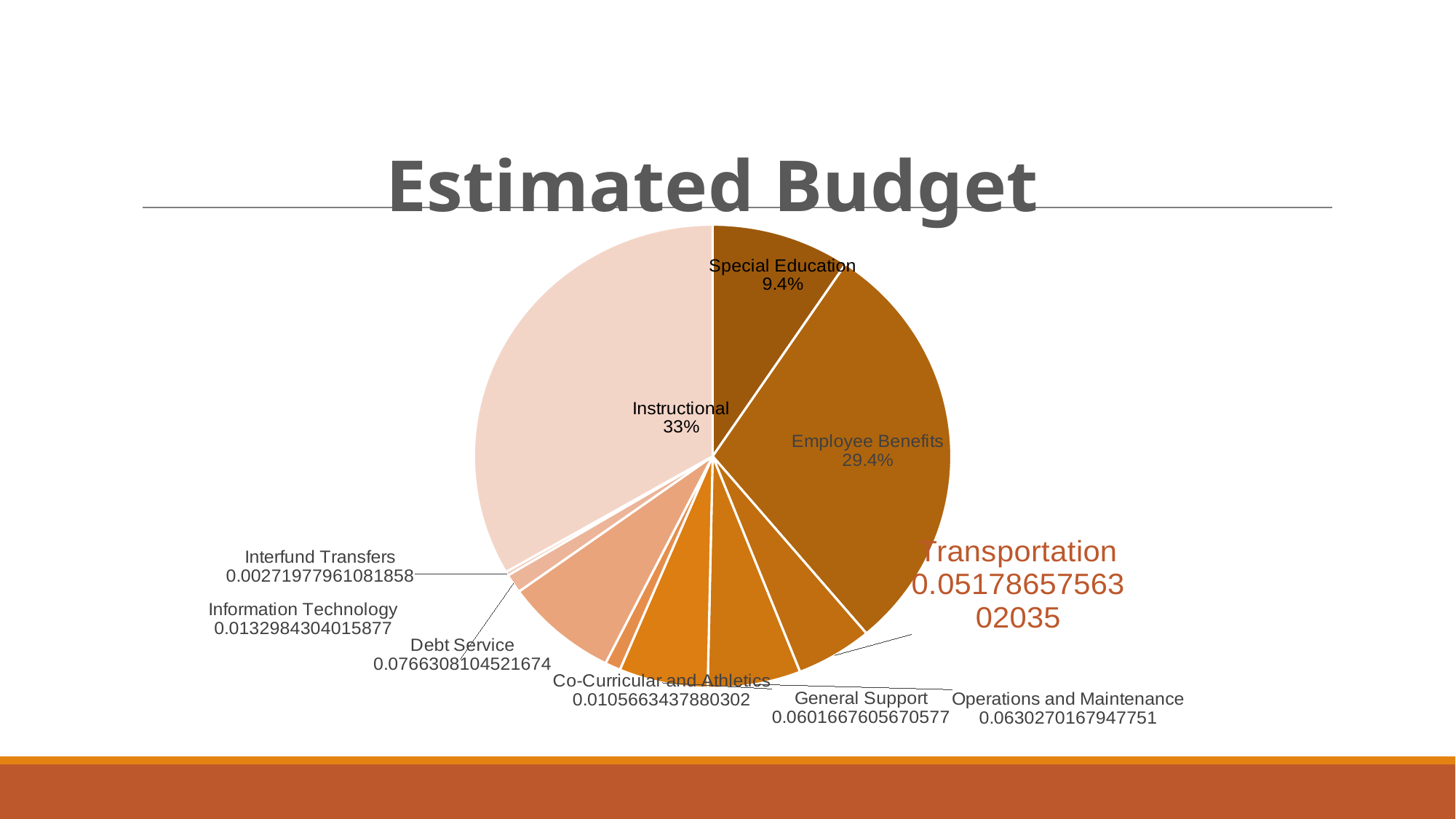
What value is shown for Transportation? 0.0517865756302035 What value is shown for Debt Service? 0.0766308104521674 What is the title of the chart? Estimated Budget What value is shown for Interfund Transfers? 0.00271977961081858 Which category has the smallest slice of the pie? Interfund Transfers What value is shown for Special Education? 9.4% Which is larger, Operations and Maintenance or General Support? Operations and Maintenance What share of the pie does Instructional represent? 33% What kind of chart is shown on the slide? pie chart What share of the pie does Employee Benefits represent? 29.4% Which category has the largest slice of the pie? Instructional How many categories are shown in the pie chart? 10